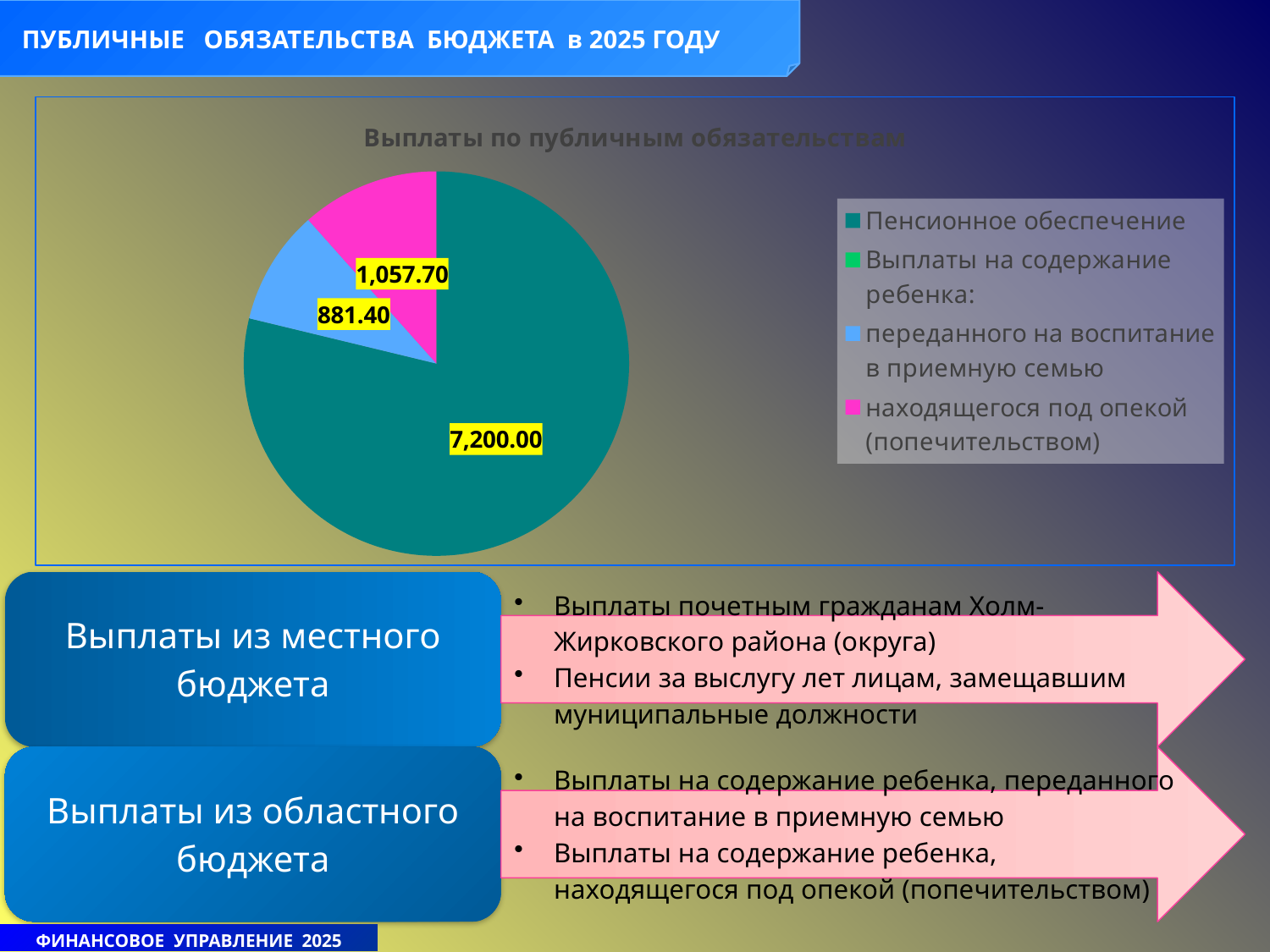
What is the title of the chart? Выплаты по публичным обязательствам What type of chart is shown on the slide? pie chart Which category has the largest slice of the pie? Пенсионное обеспечение What is the difference between the values for Пенсионное обеспечение and 'находящегося под опекой (попечительством)'? 6,142.30 What is the difference between the values for 'находящегося под опекой (попечительством)' and 'переданного на воспитание в приемную семью'? 176.30 What is the value for the slice 'переданного на воспитание в приемную семью'? 881.40 How many entries does the legend list? 4 Which labelled slice has the smallest value? переданного на воспитание в приемную семью What is the value for the slice 'находящегося под опекой (попечительством)'? 1,057.70 What colour is the slice for Пенсионное обеспечение? teal Which is larger: the value for 'находящегося под опекой (попечительством)' or for 'переданного на воспитание в приемную семью'? находящегося под опекой (попечительством) What is the value for Пенсионное обеспечение? 7,200.00